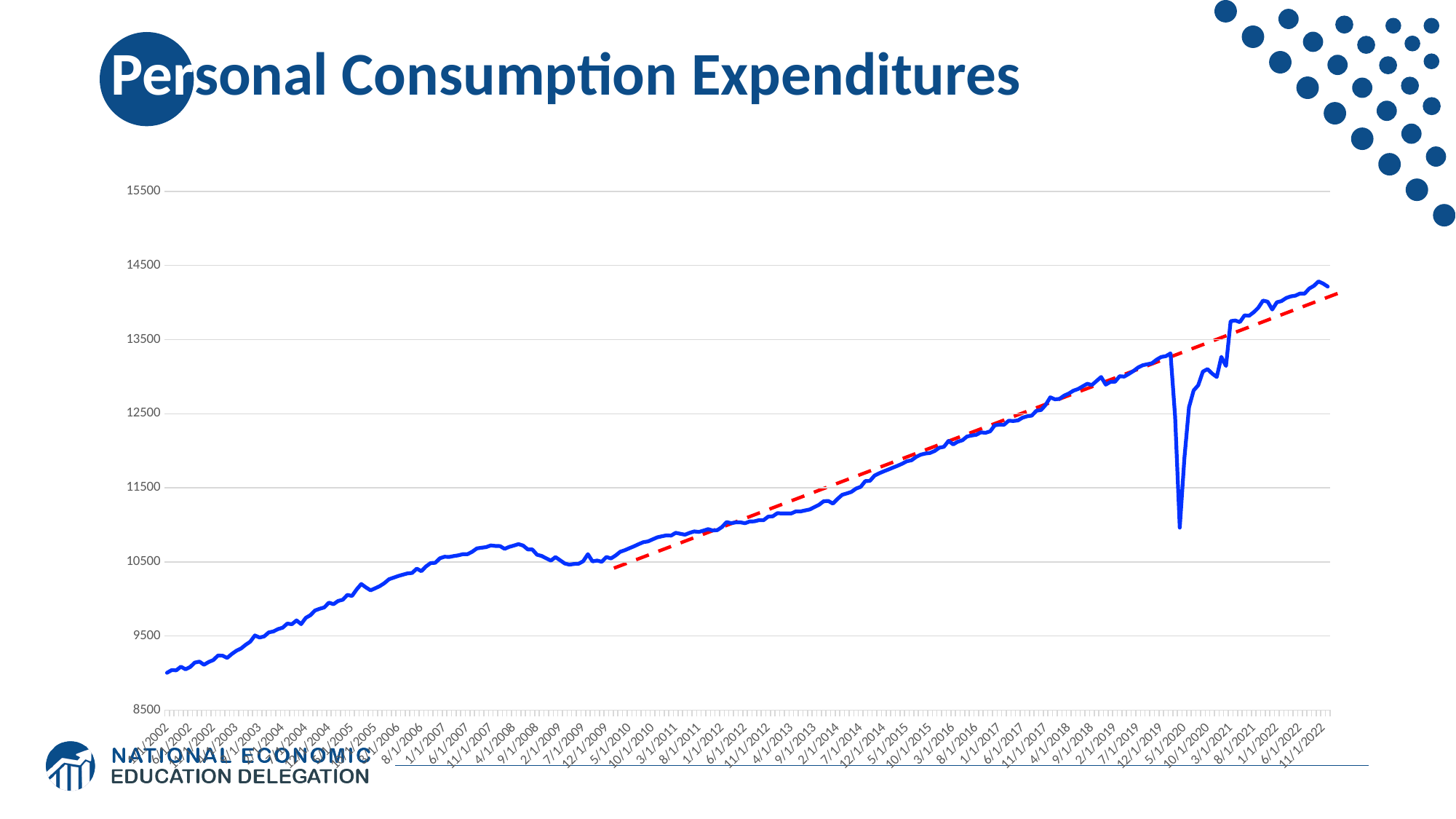
Is the value of the blue line at 5/1/2015 greater or less than 11500? greater Is the value of the blue line at 1/1/2002 greater or less than 9500? less Is the value of the blue line at 11/1/2022 greater or less than 13500? greater What kind of chart is shown on the slide? line chart Overall, do the values of the blue line rise or fall from 2002 to 2022? rise In which year does the blue line reach its lowest value? 2002 What colour is the dashed trend line on the chart? red Is the value of the blue line higher at 11/1/2022 or at 1/1/2002? 11/1/2022 What is the title of the chart? Personal Consumption Expenditures